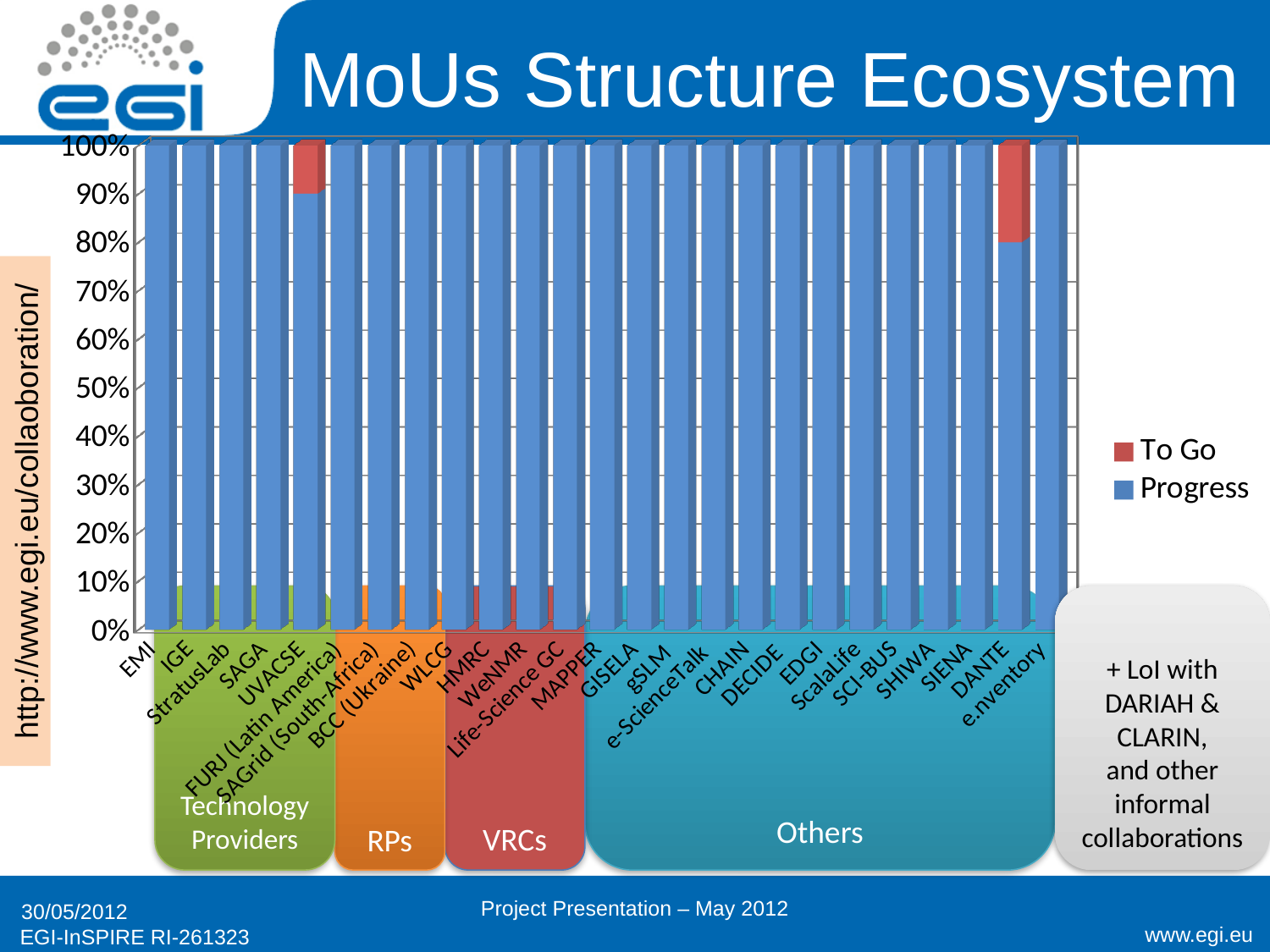
What is the total of the stacked bar for WLCG? 100% How many categories (bars) are plotted along the x axis of the chart? 25 What is the Progress value for EMI? 100% Is the Progress value for UVACSE greater or less than 80%? greater Is the Progress value for DANTE greater or less than 90%? less What colour represents the To Go series in the chart? red Which category has the highest To Go value? DANTE What is the Progress value for UVACSE? 90% Which has the larger To Go value, DANTE or UVACSE? DANTE What are the two series named in the chart legend? To Go and Progress How many series does the chart legend list? 2 What kind of chart is shown on the slide? bar chart